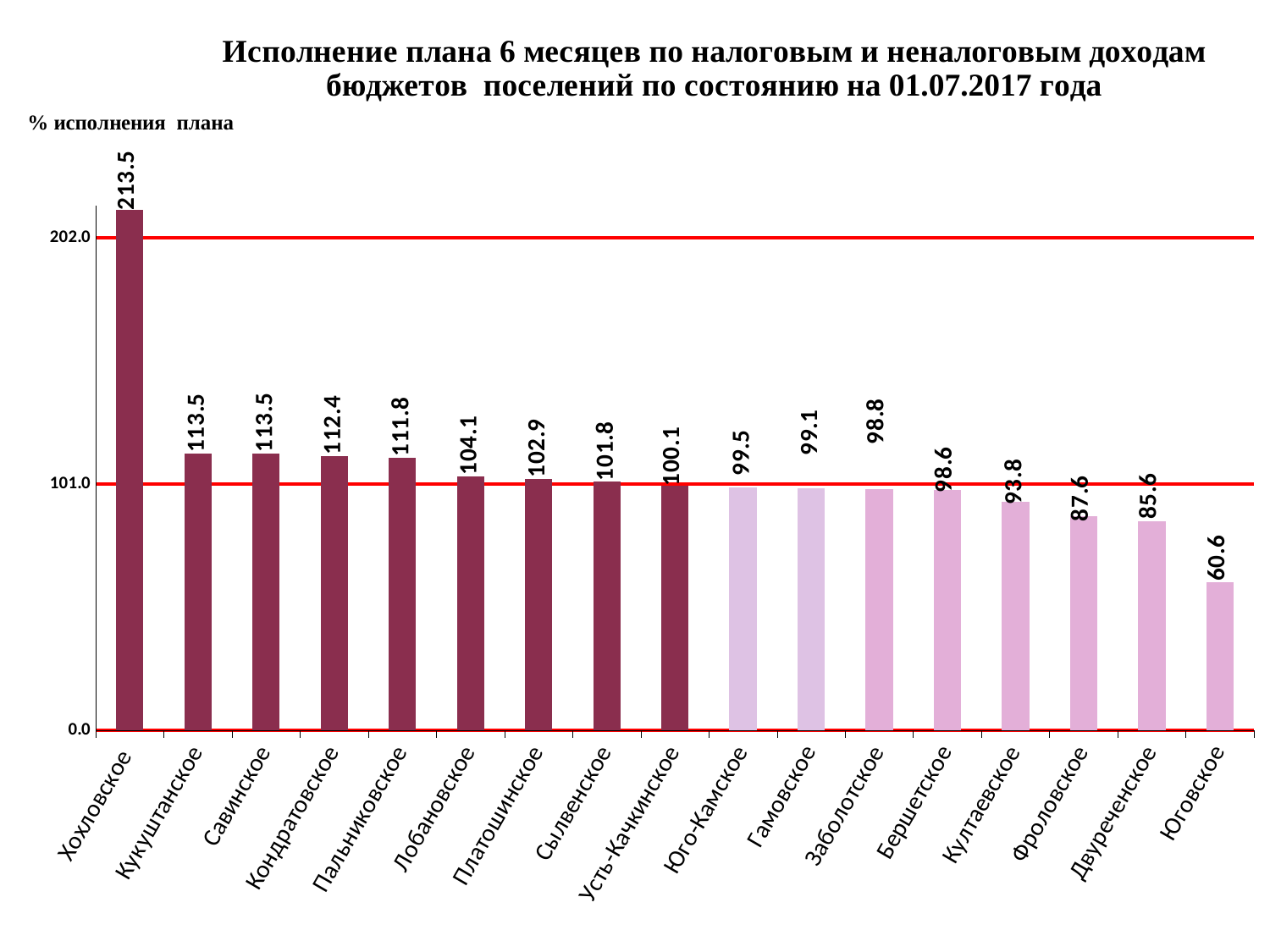
What kind of chart is shown on the slide? bar chart What is the difference between the values for Кондратовское and Пальниковское? 0.6 What is the value for Хохловское? 213.5 What is the value for Култаевское? 93.8 Is the value for Юговское greater or less than 101.0? less How many categories are shown on the x axis? 17 Which category has the highest value? Хохловское Which is larger, the value for Фроловское or the value for Двуреченское? Фроловское What is the difference between the values for Хохловское and Юговское? 152.9 Which category has the lowest value? Юговское Do the values generally rise or fall from left to right along the x axis? fall What is the value for Лобановское? 104.1